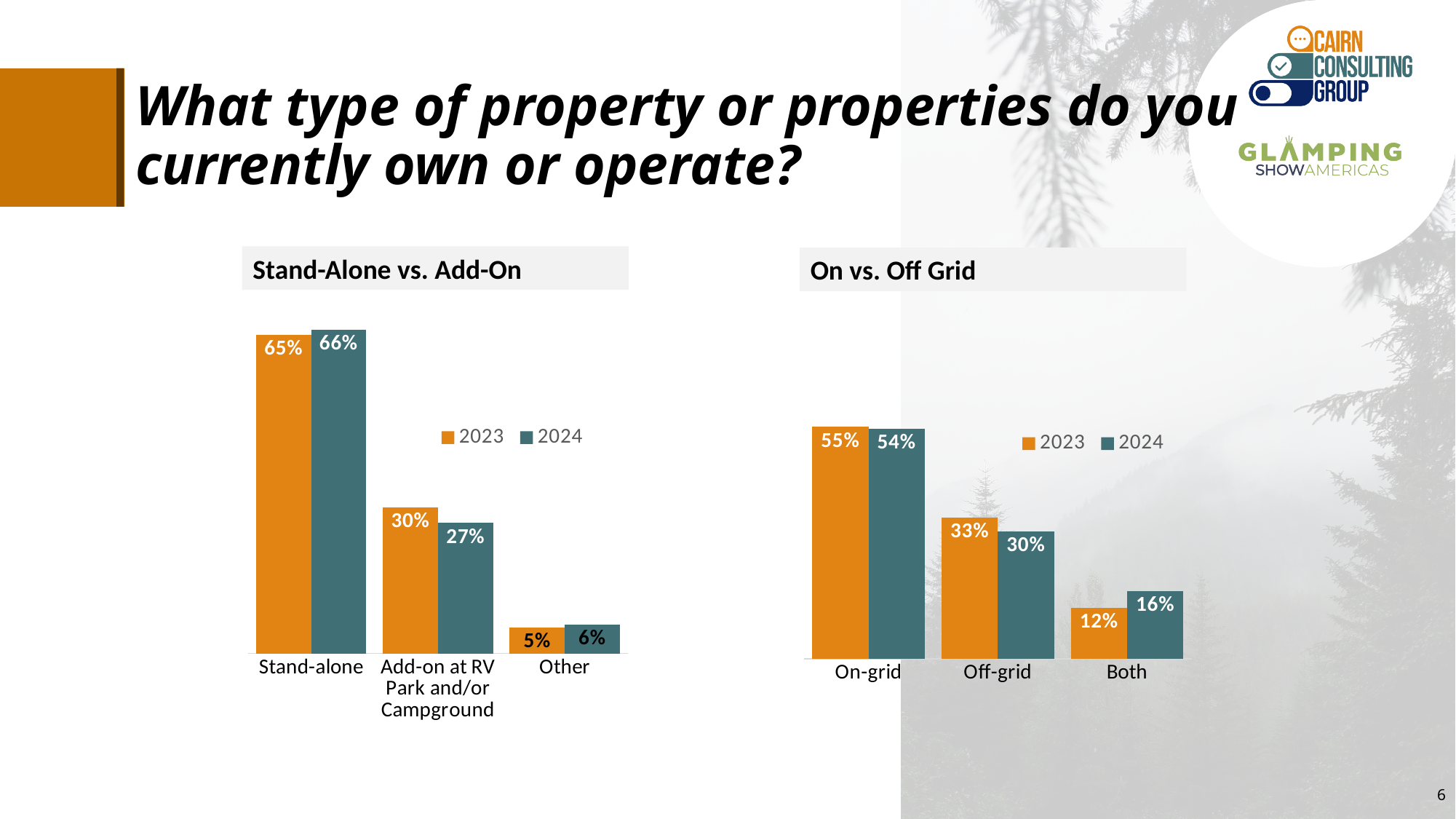
In the 'On vs. Off Grid' chart, what is the difference between the 2024 and 2023 values for Both? 4% What kind of chart is the 'On vs. Off Grid' chart? Bar chart How many series does the legend of the 'Stand-Alone vs. Add-On' chart list? 2 In the 'Stand-Alone vs. Add-On' chart, what is the 2024 value for Stand-alone? 66% In the 'Stand-Alone vs. Add-On' chart, what is the difference between the 2023 and 2024 values for Add-on at RV Park and/or Campground? 3% In the 'On vs. Off Grid' chart, what is the 2023 value for Off-grid? 33% In the 'Stand-Alone vs. Add-On' chart, which category has the lowest 2023 value? Other How many categories are shown in the 'On vs. Off Grid' chart? 3 In the 'On vs. Off Grid' chart, what is the 2024 value for Both? 16% In the 'On vs. Off Grid' chart, which is larger for Off-grid: the 2023 value or the 2024 value? 2023 In the 'Stand-Alone vs. Add-On' chart, what is the 2023 value for Add-on at RV Park and/or Campground? 30% In the 'On vs. Off Grid' chart, which category has the highest 2024 value? On-grid